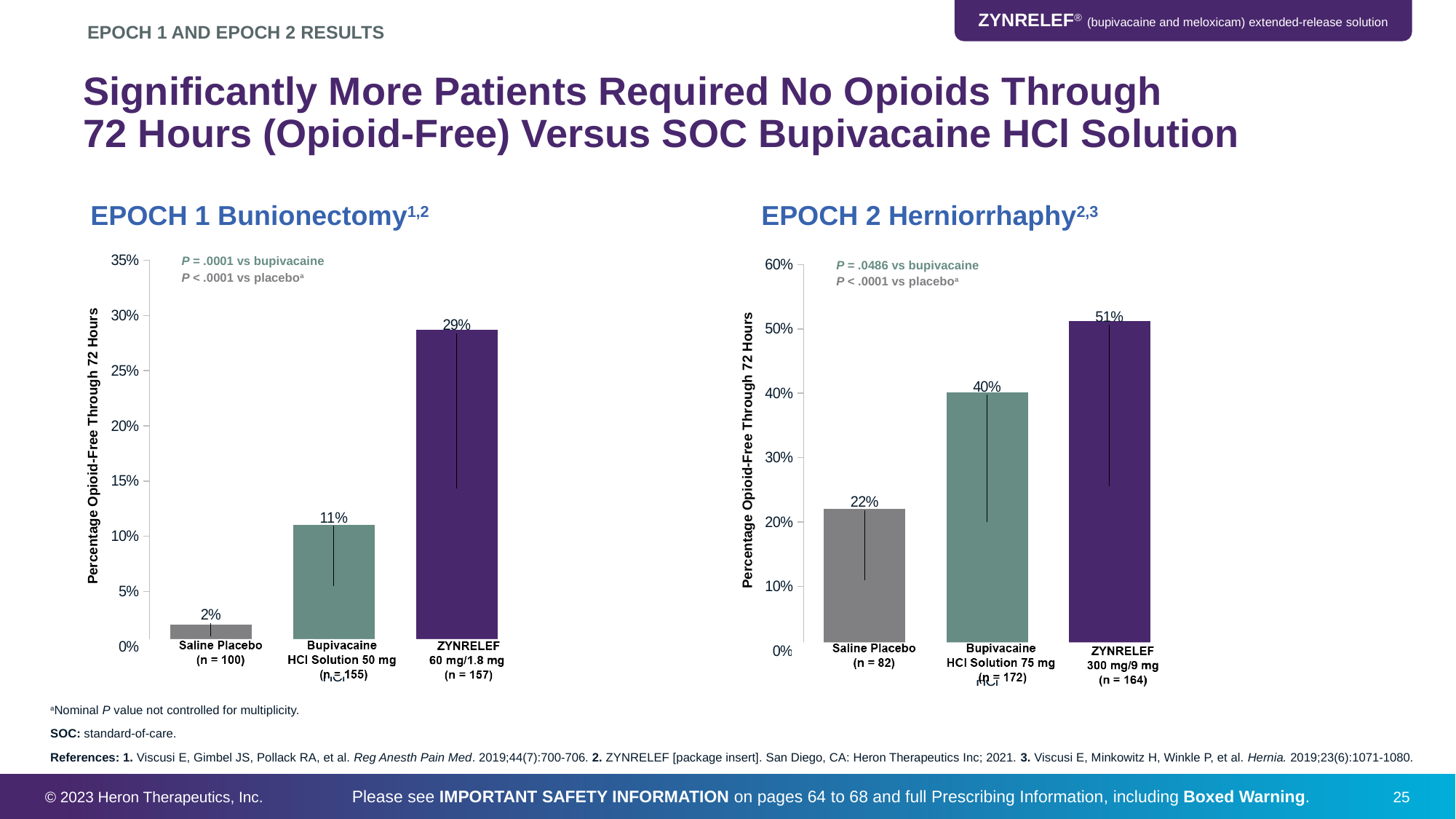
In the EPOCH 1 Bunionectomy chart, what is the value for Bupivacaine HCl Solution 50 mg? 11% In the EPOCH 2 Herniorrhaphy chart, which treatment group has the highest percentage of opioid-free patients? ZYNRELEF 300 mg/9 mg In the EPOCH 2 Herniorrhaphy chart, which is larger: the value for Bupivacaine HCl Solution 75 mg or the value for Saline Placebo? Bupivacaine HCl Solution 75 mg In the EPOCH 1 Bunionectomy chart, what percentage of patients were opioid-free through 72 hours with ZYNRELEF 60 mg/1.8 mg? 29% In the EPOCH 1 Bunionectomy chart, which treatment group has the lowest percentage of opioid-free patients? Saline Placebo How many treatment groups are shown in the EPOCH 1 Bunionectomy chart? 3 In the EPOCH 1 Bunionectomy chart, what is the difference between the ZYNRELEF value and the Bupivacaine HCl Solution 50 mg value? 18% In the EPOCH 2 Herniorrhaphy chart, what is the difference between the ZYNRELEF value and the Saline Placebo value? 29% In the EPOCH 2 Herniorrhaphy chart, what percentage of patients were opioid-free through 72 hours with ZYNRELEF 300 mg/9 mg? 51% In the EPOCH 2 Herniorrhaphy chart, what is the value for Saline Placebo? 22% In the EPOCH 1 Bunionectomy chart, what is the P value for ZYNRELEF vs bupivacaine? P = .0001 What type of chart is used for the EPOCH 2 Herniorrhaphy results? Bar chart